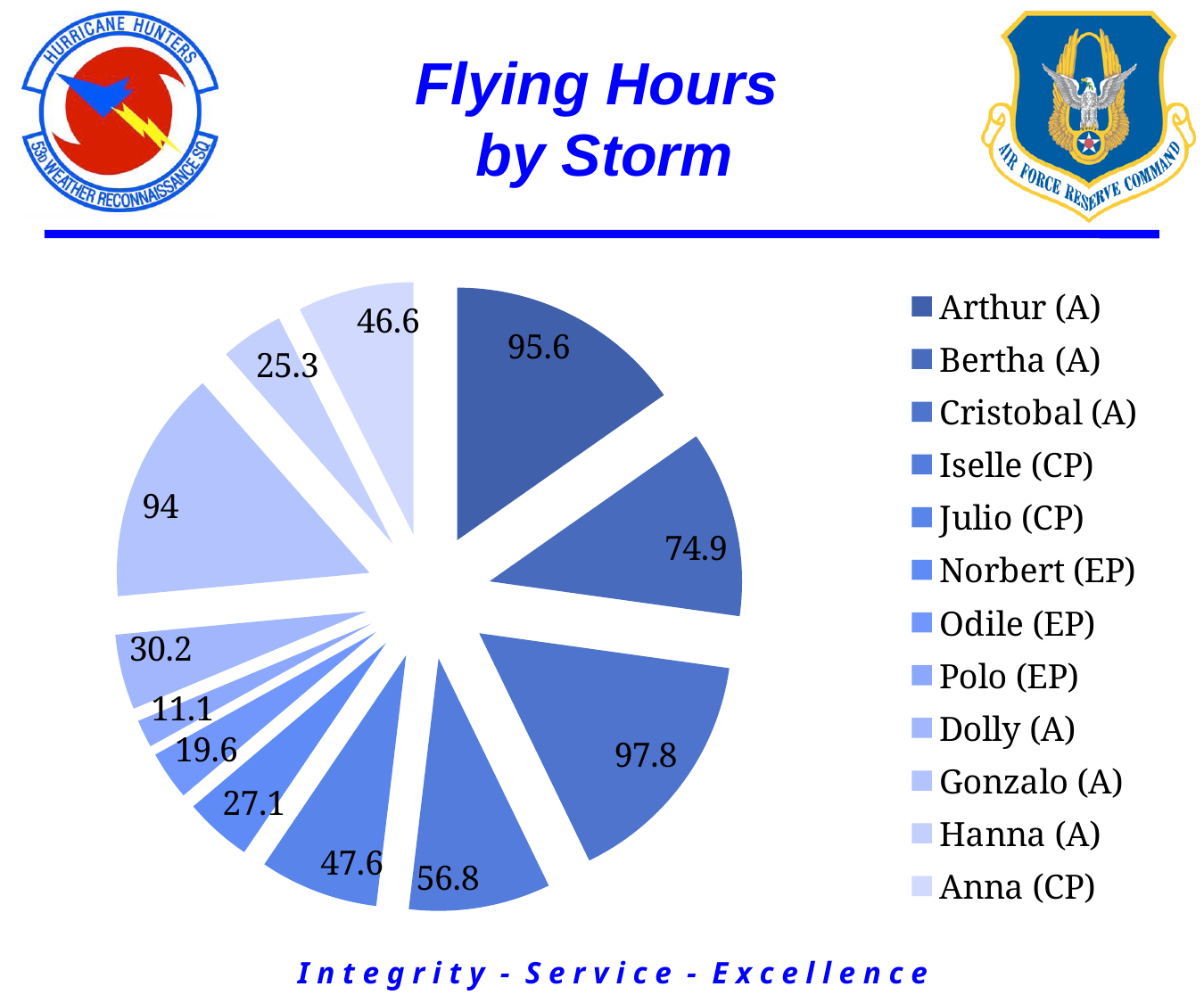
How many flying hours are shown for Anna (CP)? 46.6 What type of chart is shown on the slide? pie chart What is the title of the chart on the slide? Flying Hours by Storm What is the difference in flying hours between Dolly (A) and Hanna (A)? 4.9 What is the difference in flying hours between Arthur (A) and Bertha (A)? 20.7 Which storm has the lowest number of flying hours? Polo (EP) How many flying hours are shown for Cristobal (A)? 97.8 How many storms are listed in the legend of the Flying Hours by Storm chart? 12 How many flying hours are shown for Gonzalo (A)? 94 How many flying hours are shown for Polo (EP)? 11.1 Which storm has the highest number of flying hours? Cristobal (A) Which storm has more flying hours, Iselle (CP) or Julio (CP)? Iselle (CP)